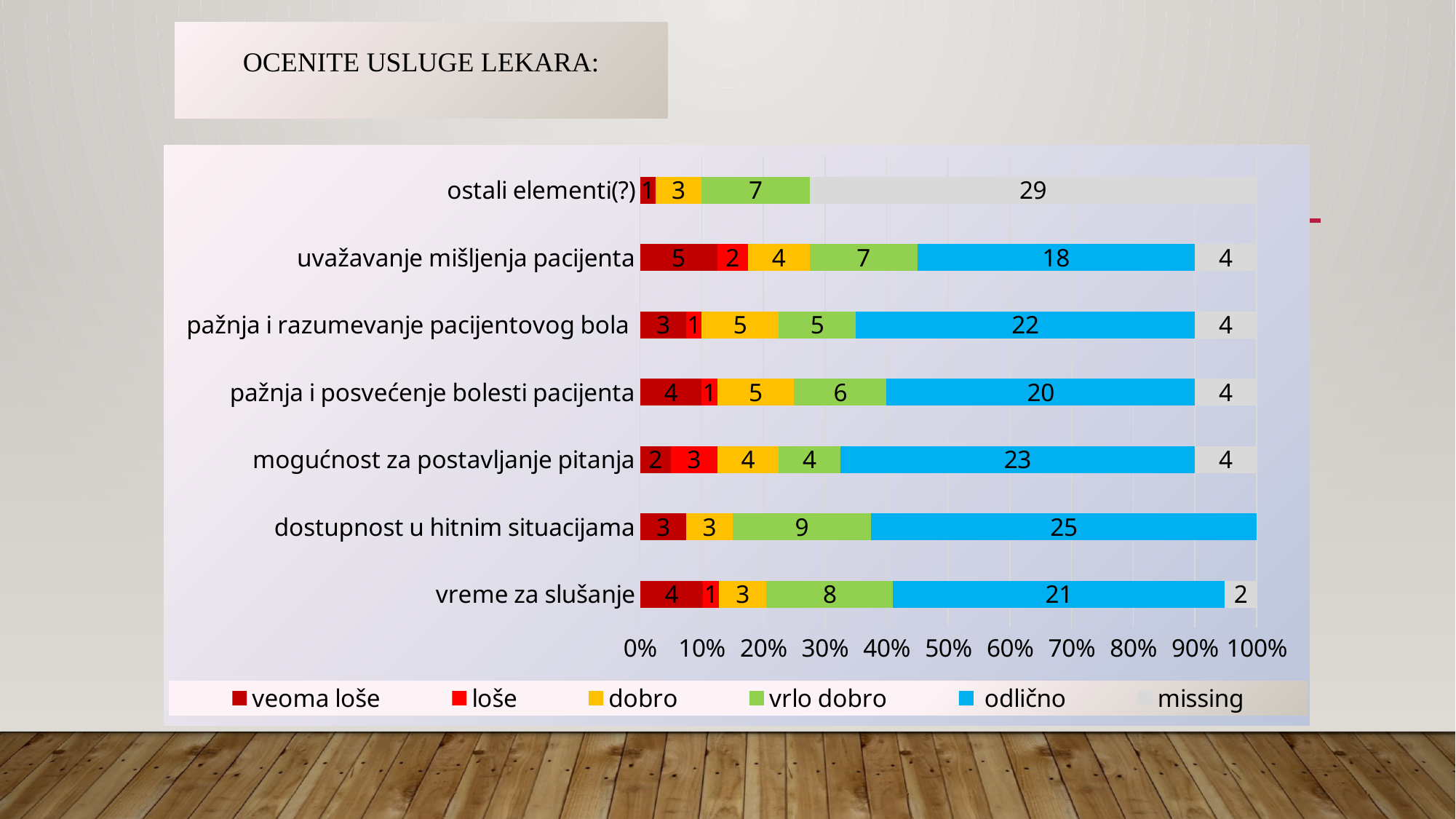
What is the total of all labelled segments in the 'uvažavanje mišljenja pacijenta' bar? 40 What is the 'vrlo dobro' value for 'vreme za slušanje'? 8 What kind of chart is shown on the slide? stacked bar chart Which category has the highest 'odlično' value? dostupnost u hitnim situacijama What is the 'missing' value for 'ostali elementi(?)'? 29 What is the 'odlično' value for 'dostupnost u hitnim situacijama'? 25 How many series does the legend list? 6 What is the difference between the 'odlično' values for 'mogućnost za postavljanje pitanja' and 'uvažavanje mišljenja pacijenta'? 5 Which is larger: the 'dobro' value for 'pažnja i razumevanje pacijentovog bola' or the 'dobro' value for 'vreme za slušanje'? pažnja i razumevanje pacijentovog bola How many categories are plotted on the chart? 7 What colour represents the 'odlično' series in the legend? blue Which category has the highest 'veoma loše' value? uvažavanje mišljenja pacijenta